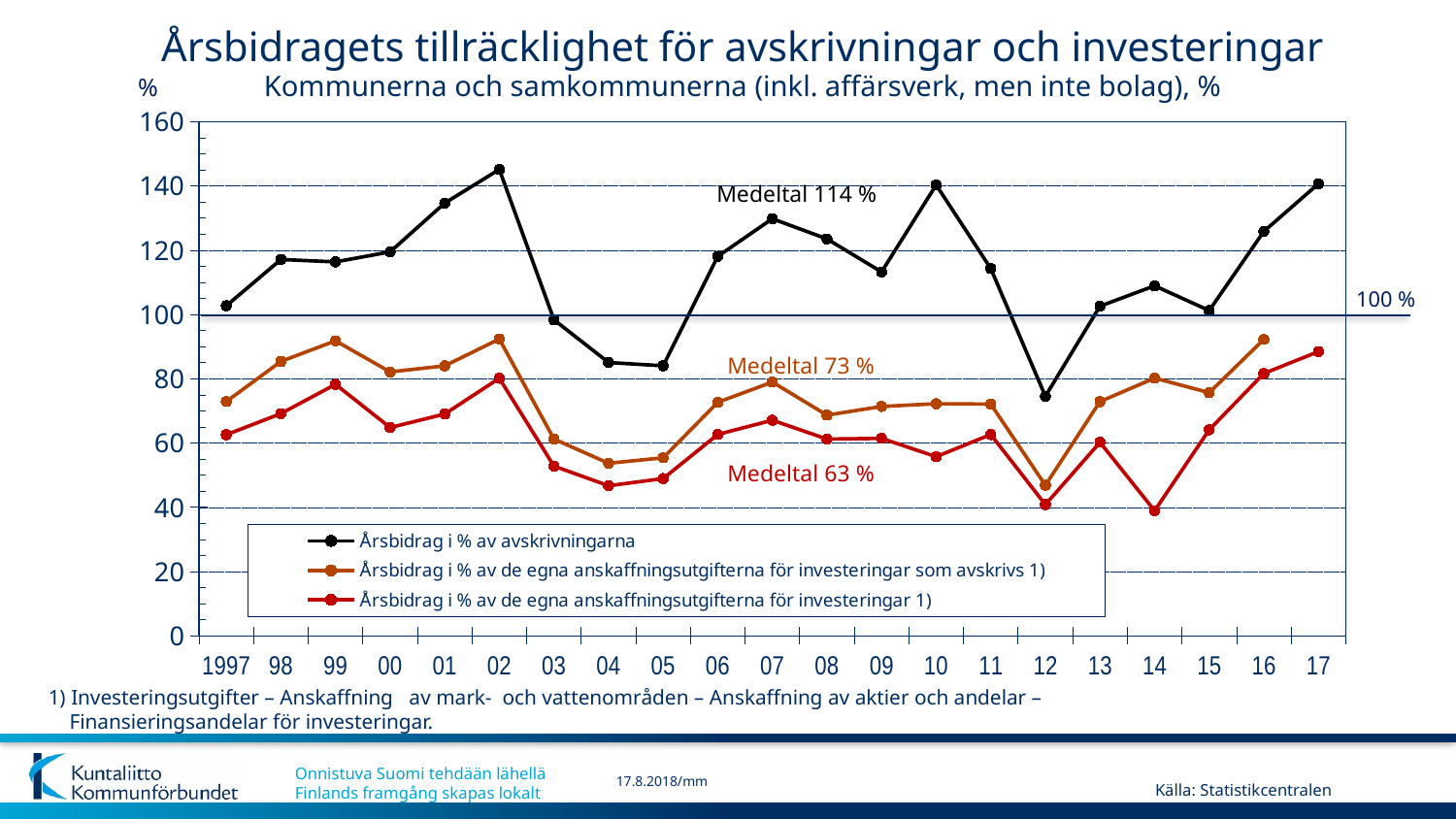
Is the value for 'Årsbidrag i % av avskrivningarna' in 12 greater or less than 80? less What average (Medeltal) is annotated for the series 'Årsbidrag i % av avskrivningarna'? 114 % What kind of chart is shown on the slide? line chart In which year does the series 'Årsbidrag i % av avskrivningarna' reach its highest value? 02 What average (Medeltal) is annotated for the series 'Årsbidrag i % av de egna anskaffningsutgifterna för investeringar 1)'? 63 % Is the value for 'Årsbidrag i % av de egna anskaffningsutgifterna för investeringar som avskrivs 1)' in 04 greater or less than 60? less How many series does the legend list? 3 Is the value for 'Årsbidrag i % av avskrivningarna' in 02 greater or less than 140? greater Does the series 'Årsbidrag i % av avskrivningarna' rise or fall from 12 to 17? rise Which is larger for 'Årsbidrag i % av avskrivningarna': the value in 09 or the value in 10? 10 How many years are plotted along the x axis? 21 In which year does the series 'Årsbidrag i % av avskrivningarna' reach its lowest value? 12